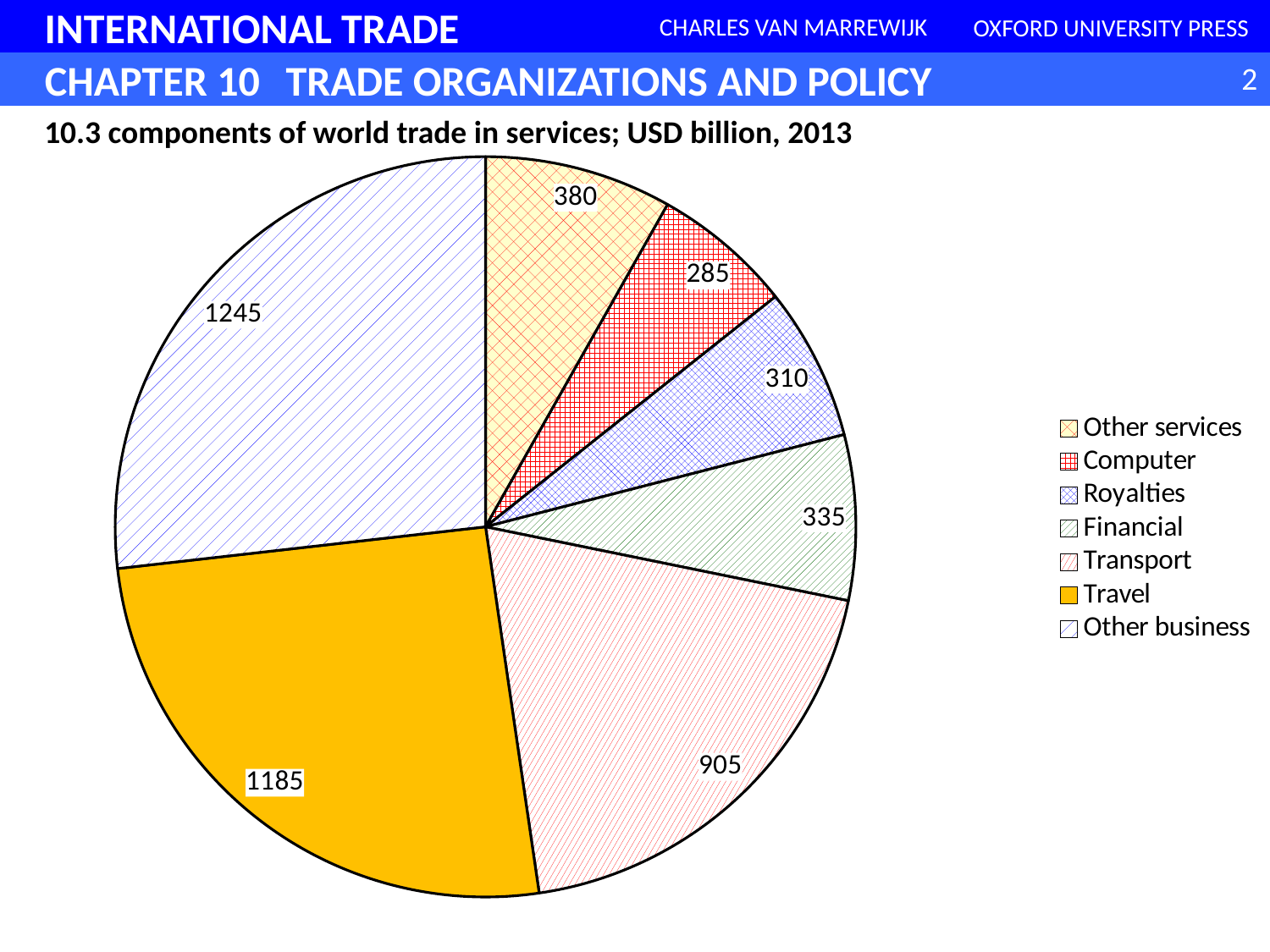
Which component has the largest value? Other business Which component has the smallest value? Computer How many components are shown in the pie chart? 7 Which is larger, Royalties or Other services? Other services What is the difference between the values for Other business and Travel? 60 What kind of chart is shown on the slide? pie chart What is the value for Travel? 1185 What is the title of the chart? 10.3 components of world trade in services; USD billion, 2013 What is the total of all the components shown in the pie chart? 4645 What is the value for Transport? 905 What is the value for Financial? 335 What is the value for Computer? 285